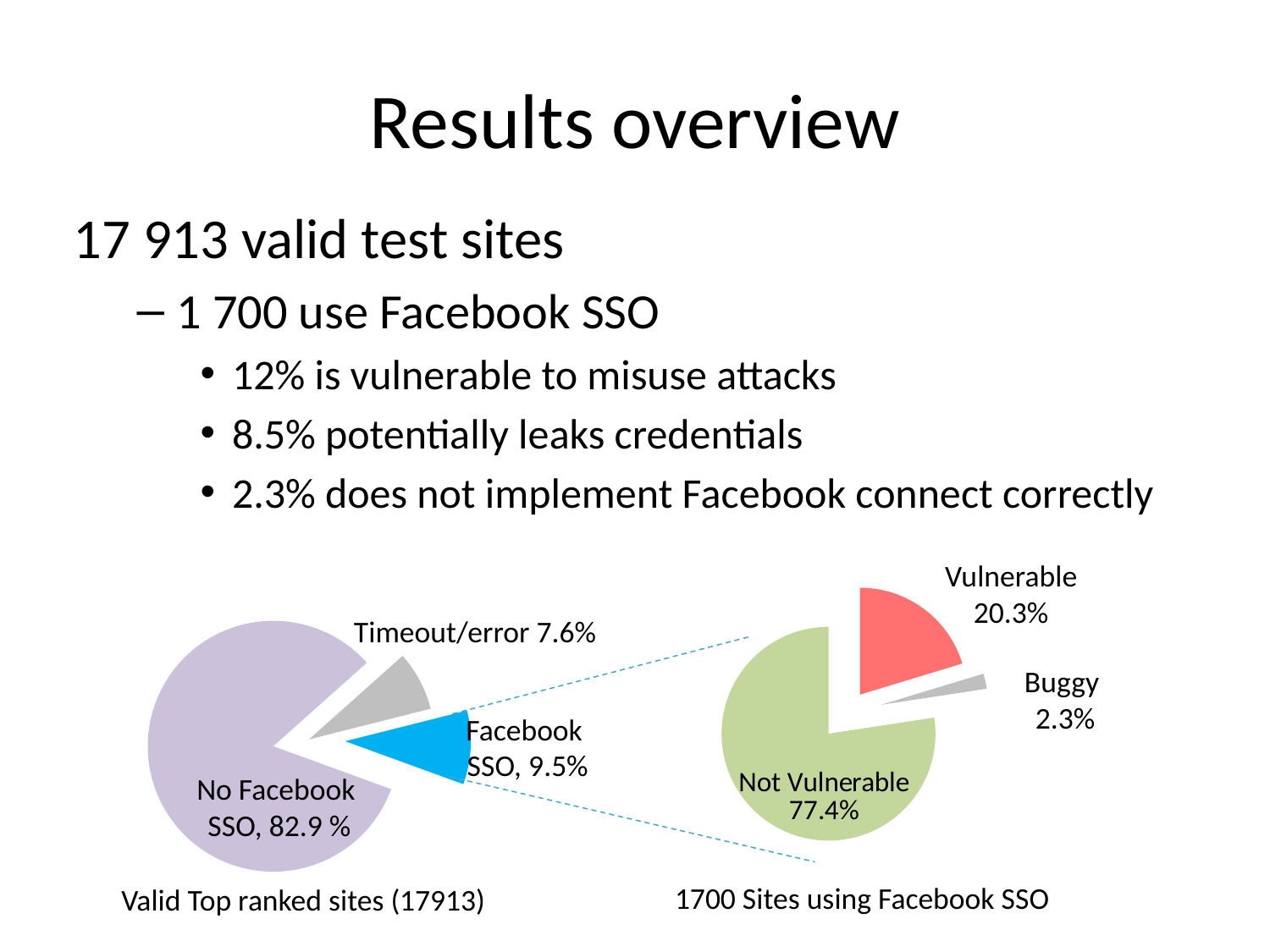
In the '1700 Sites using Facebook SSO' pie chart, what colour is the Vulnerable slice? Red In the '1700 Sites using Facebook SSO' pie chart, what share is labelled for Vulnerable? 20.3% In the '1700 Sites using Facebook SSO' pie chart, what share is labelled for Not Vulnerable? 77.4% In the 'Valid Top ranked sites (17913)' pie chart, which slice is the largest? No Facebook SSO What kind of charts are shown on the slide? Pie charts In the '1700 Sites using Facebook SSO' pie chart, which slice is the smallest? Buggy In the 'Valid Top ranked sites (17913)' pie chart, how many slices are there? 3 In the '1700 Sites using Facebook SSO' pie chart, what is the difference between the Vulnerable and Buggy shares? 18 percentage points In the 'Valid Top ranked sites (17913)' pie chart, what share is labelled for Timeout/error? 7.6% In the 'Valid Top ranked sites (17913)' pie chart, what share is labelled for No Facebook SSO? 82.9 % In the 'Valid Top ranked sites (17913)' pie chart, which slice is the smallest? Timeout/error In the 'Valid Top ranked sites (17913)' pie chart, what share is labelled for Facebook SSO? 9.5%